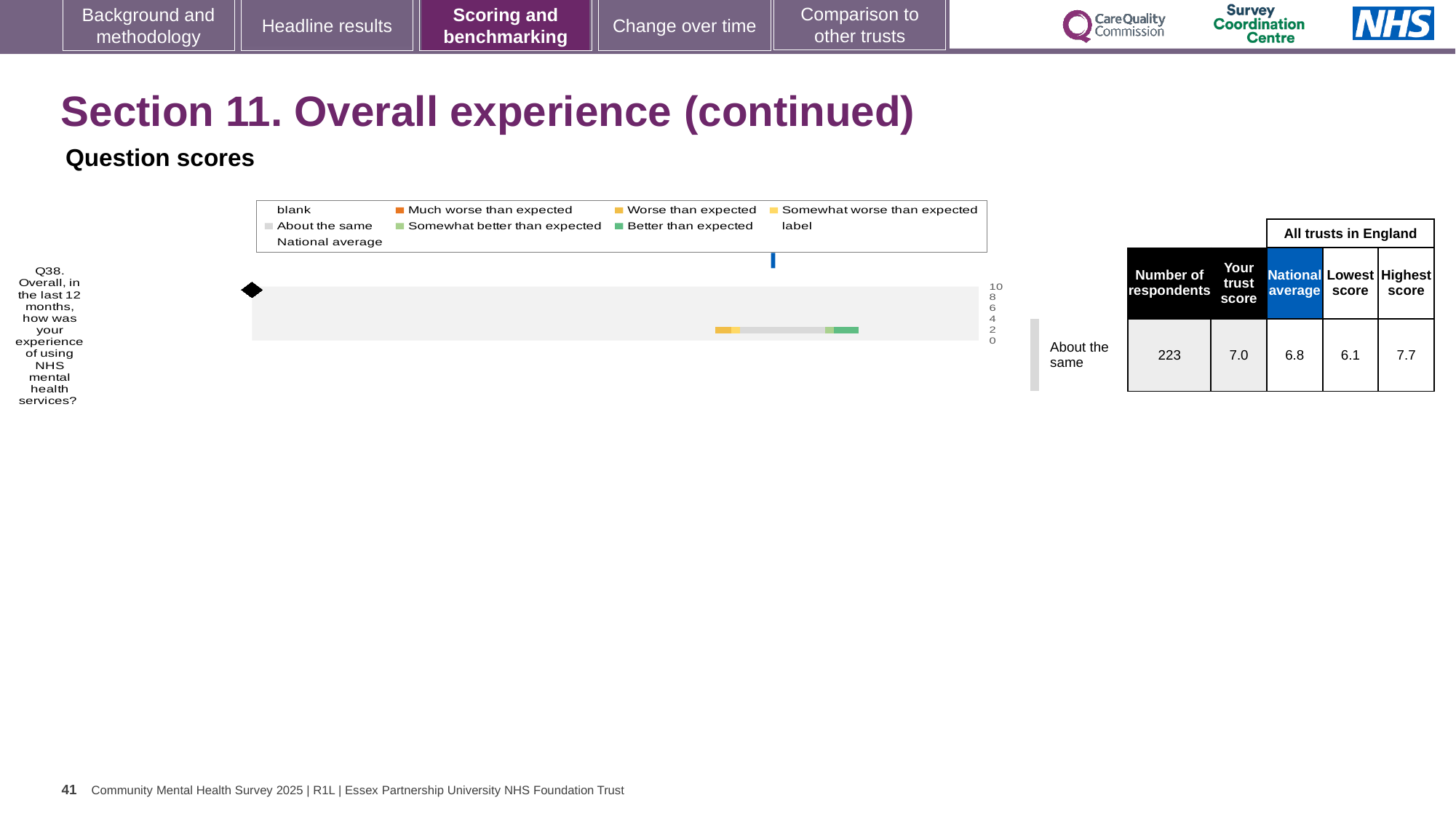
What kind of chart is shown for Q38 on this slide? bar chart How many survey questions are plotted in the chart on this slide? 1 What is the national average score for Q38? 6.8 What is the lowest score among all trusts in England for Q38? 6.1 What colour represents 'Better than expected' in the chart legend? Green Which is larger for Q38, the trust's score or the national average? Your trust score What benchmarking category is the trust's Q38 result placed in? About the same What is the difference between the highest and lowest scores for Q38 across all trusts in England? 1.6 What is the highest score among all trusts in England for Q38? 7.7 How many respondents answered Q38? 223 What is the difference between the trust's score and the national average for Q38? 0.2 What is the trust's score for Q38 according to the table next to the chart? 7.0